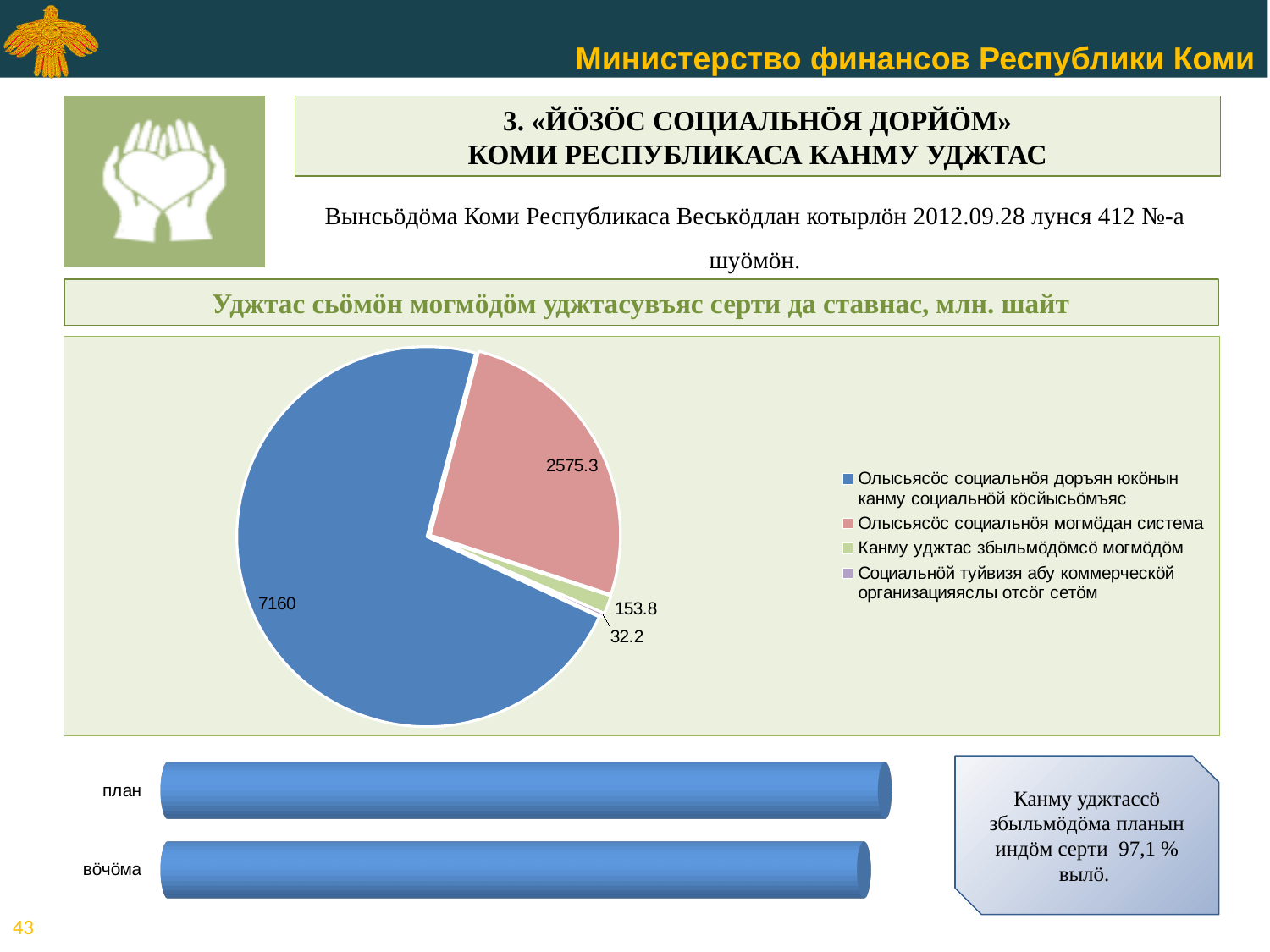
What kind of chart is the chart at the bottom of the slide with the categories "план" and "вöчöма"? bar chart In the pie chart, what is the value for "Канму уджтас збыльмöдöмсö могмöдöм"? 153.8 In the pie chart, what is the difference between the values 153.8 and 32.2? 121.6 In the bar chart at the bottom of the slide, which bar is longer: "план" or "вöчöма"? план In the pie chart, what is the value for "Социальнöй туйвизя абу коммерческöй организацияяслы отсöг сетöм"? 32.2 How many entries does the pie chart's legend list? 4 In the pie chart, what is the value for "Олысьясöс социальнöя могмöдан система"? 2575.3 How many slices does the pie chart have? 4 In the pie chart, which category has the largest slice? Олысьясöс социальнöя доръян юкöнын канму социальнöй кöсйысьöмъяс In the pie chart, what is the difference between the largest slice (7160) and the slice for "Олысьясöс социальнöя могмöдан система"? 4584.7 In the pie chart, which is larger: the slice for "Канму уджтас збыльмöдöмсö могмöдöм" or the slice for "Социальнöй туйвизя абу коммерческöй организацияяслы отсöг сетöм"? Канму уджтас збыльмöдöмсö могмöдöм In the pie chart, which category has the smallest slice? Социальнöй туйвизя абу коммерческöй организацияяслы отсöг сетöм